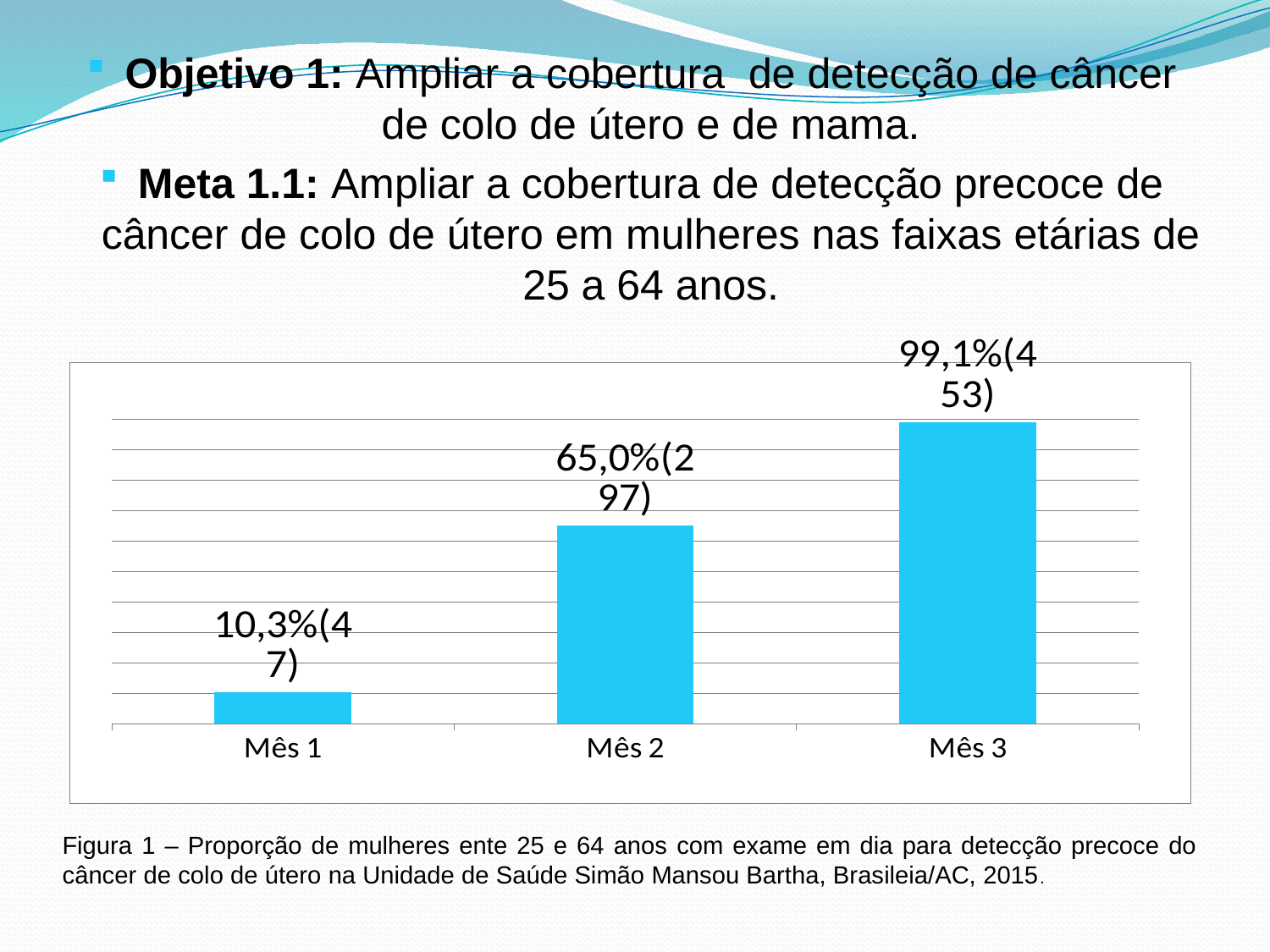
Do the values rise or fall from Mês 1 to Mês 3? Rise Which month has the lowest value? Mês 1 What is the difference in percentage between Mês 3 and Mês 1? 88,8% Which is larger, the value for Mês 2 or the value for Mês 3? Mês 3 How many months (categories) are shown in the chart? 3 What kind of chart is shown on the slide? Bar chart What percentage is shown for Mês 3? 99,1% What is the difference in percentage between Mês 2 and Mês 1? 54,7% What is the value shown for Mês 2? 65,0%(297) How many women are shown in parentheses for Mês 3? 453 Which month has the highest value? Mês 3 What is the value shown for Mês 1? 10,3%(47)